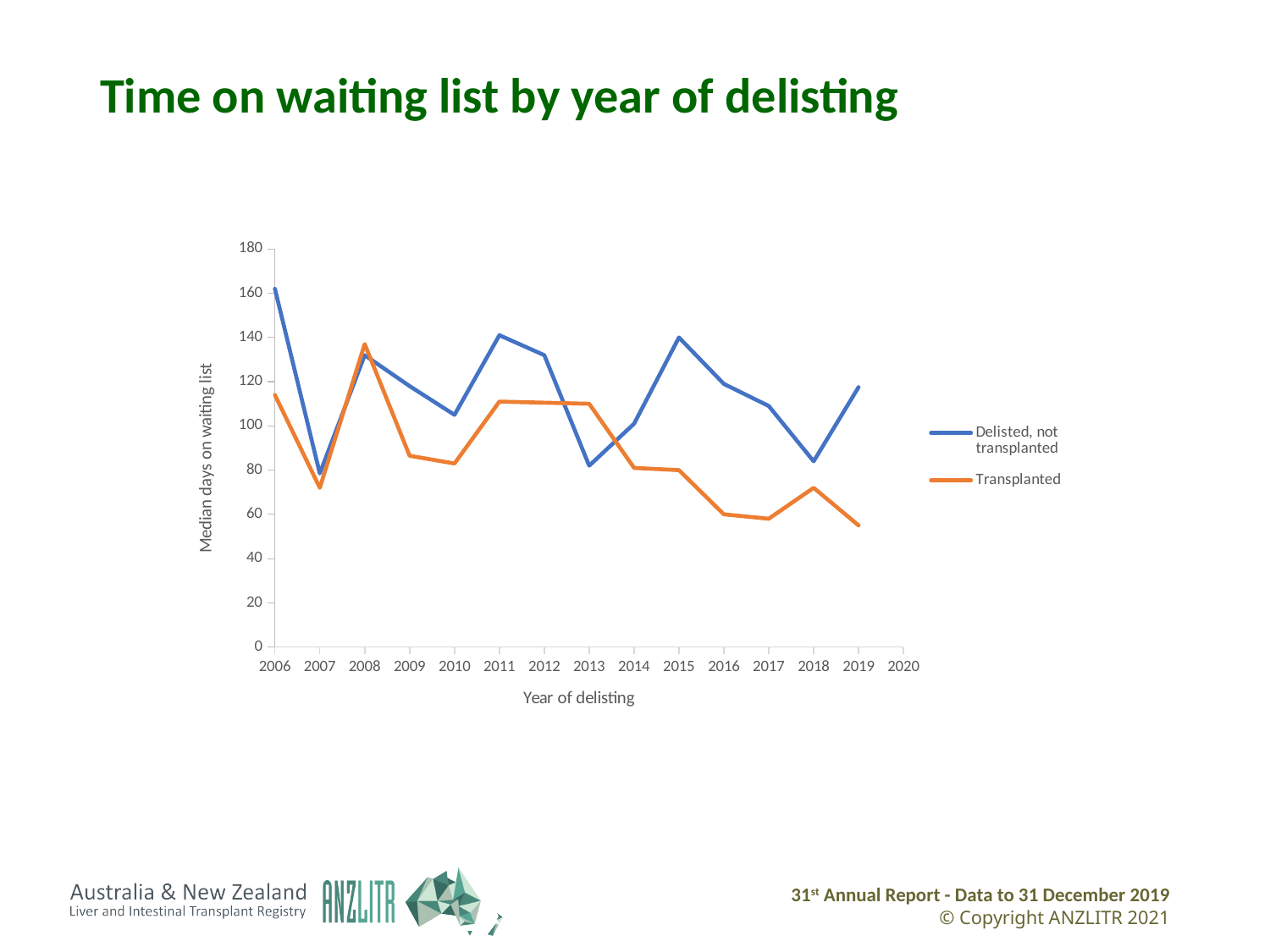
In 2013, which series has the higher median days on waiting list? Transplanted What is the label of the vertical axis? Median days on waiting list In which year is the 'Delisted, not transplanted' series at its highest? 2006 In which year is the 'Transplanted' series at its highest? 2008 How many series does the legend list? 2 Is the value for 'Transplanted' in 2016 greater or less than 80? less Does the 'Transplanted' series rise or fall from 2013 to 2017? Fall How many years have data points plotted for each series? 14 Is the value for 'Delisted, not transplanted' in 2006 greater or less than 140? greater What kind of chart is shown on the slide? Line chart Is the value for 'Transplanted' in 2019 greater or less than 60? less In 2015, which series has the higher median days on waiting list? Delisted, not transplanted